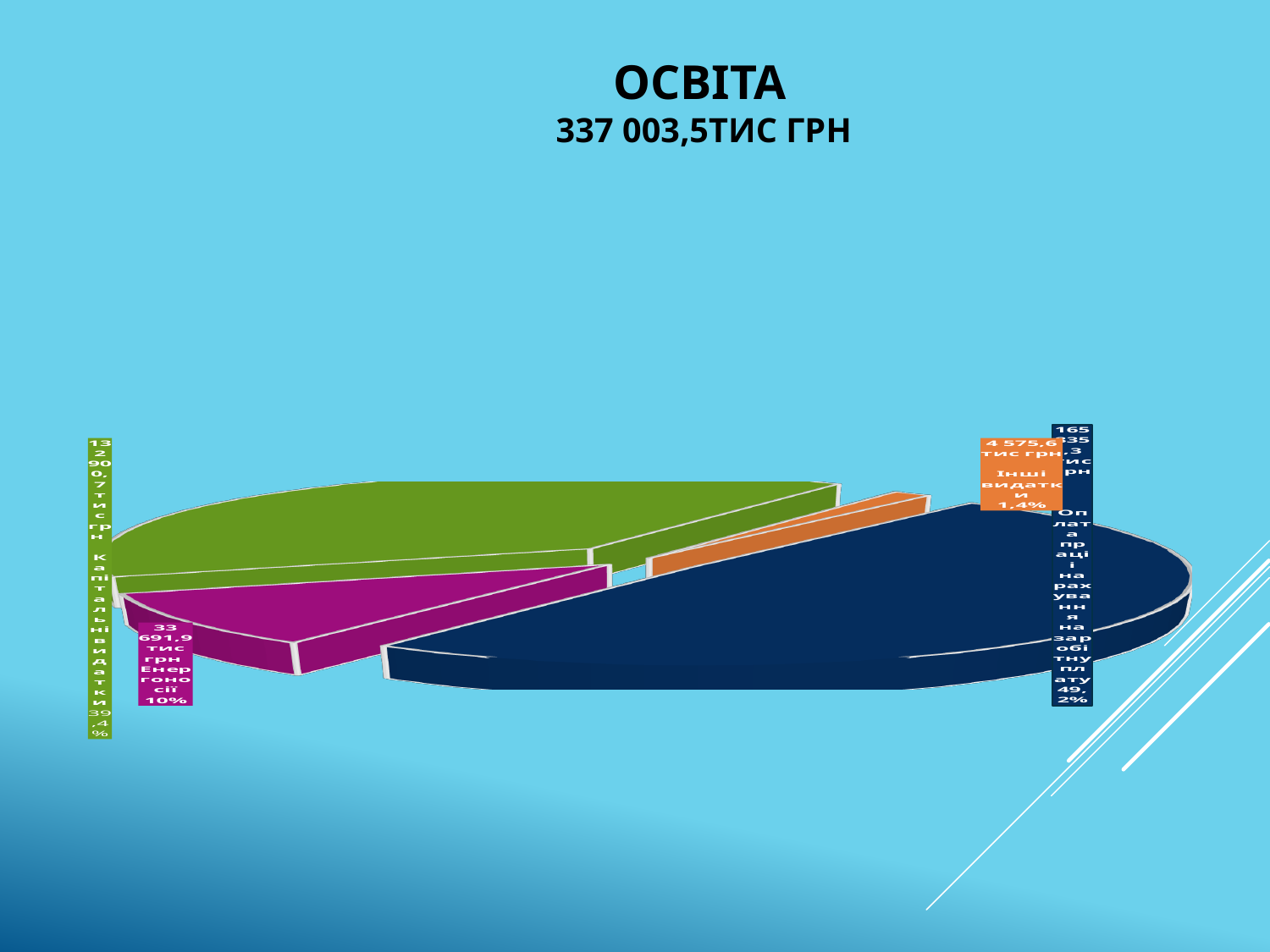
What is the title of the chart? ОСВІТА 337 003,5 ТИС ГРН What share of the pie is Інші видатки? 1,4% What is the value for Енергоносії? 33 691,9 тис грн What kind of chart is shown on the slide? pie chart How many slices does the pie chart have? 4 What is the value for Інші видатки? 4 575,6 тис грн Which category has the smallest slice? Інші видатки Which is larger, the share for Капітальні видатки or the share for Енергоносії? Капітальні видатки What share of the pie is Оплата праці з нарахуваннями на заробітну плату? 49,2% What share of the pie is Енергоносії? 10% Which category has the largest slice? Оплата праці і нарахування на заробітну плату